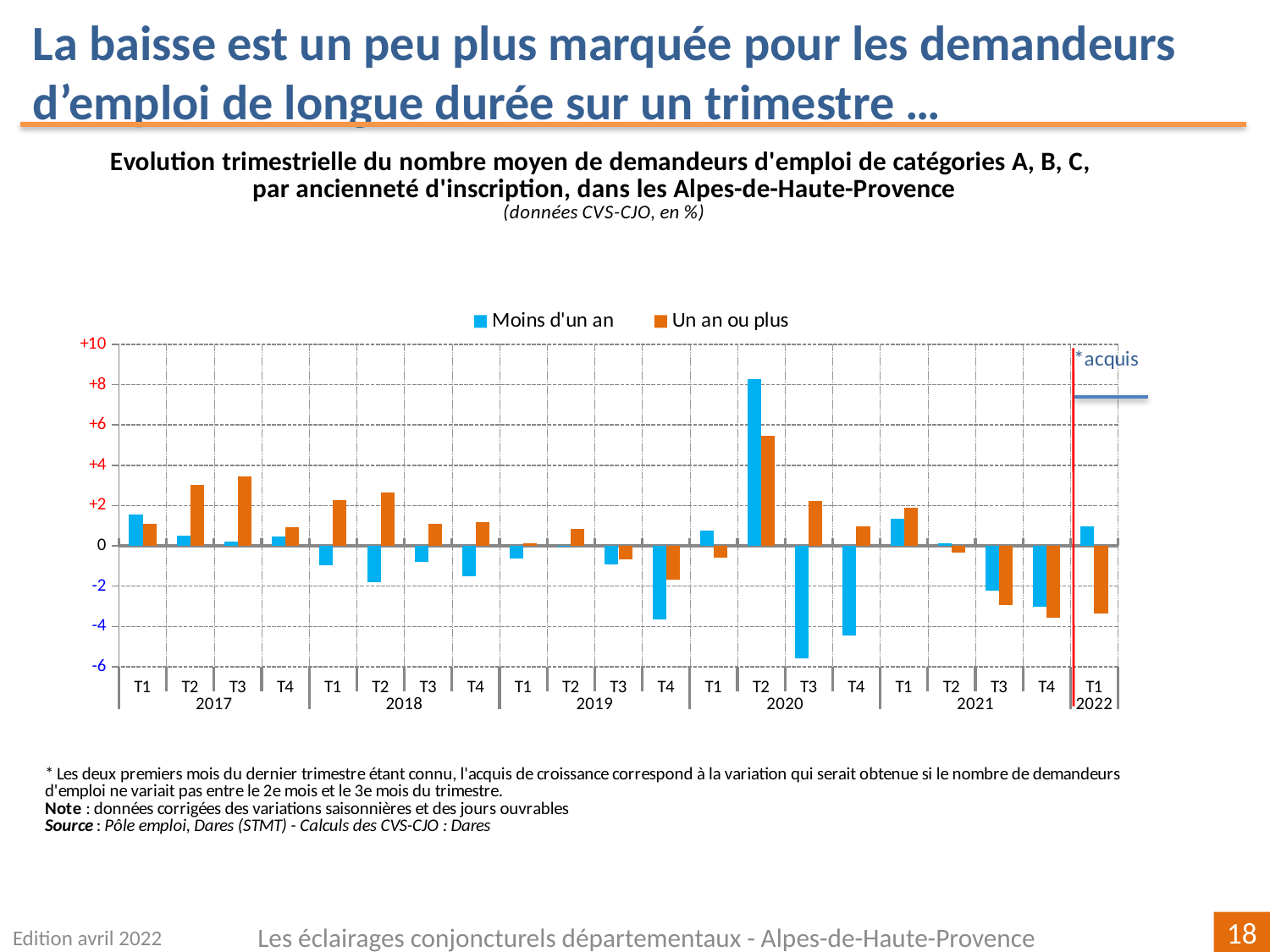
Is the value for 'Un an ou plus' in T1 2022 greater or less than -2? less Is the value for 'Moins d'un an' in T3 2020 greater or less than -4? less How many quarters are plotted on the x axis? 21 In which quarter does the 'Moins d'un an' series reach its highest value? T2 2020 In which quarter does the 'Moins d'un an' series reach its lowest value? T3 2020 In T2 2020, which series has the larger value, 'Moins d'un an' or 'Un an ou plus'? Moins d'un an Which series are listed in the legend? Moins d'un an; Un an ou plus What kind of chart is shown on the slide? Bar chart In T3 2017, which series has the larger value, 'Moins d'un an' or 'Un an ou plus'? Un an ou plus How many series does the legend list? 2 Is the value for 'Moins d'un an' in T2 2020 greater or less than +6? greater In which quarter does the 'Un an ou plus' series reach its highest value? T2 2020